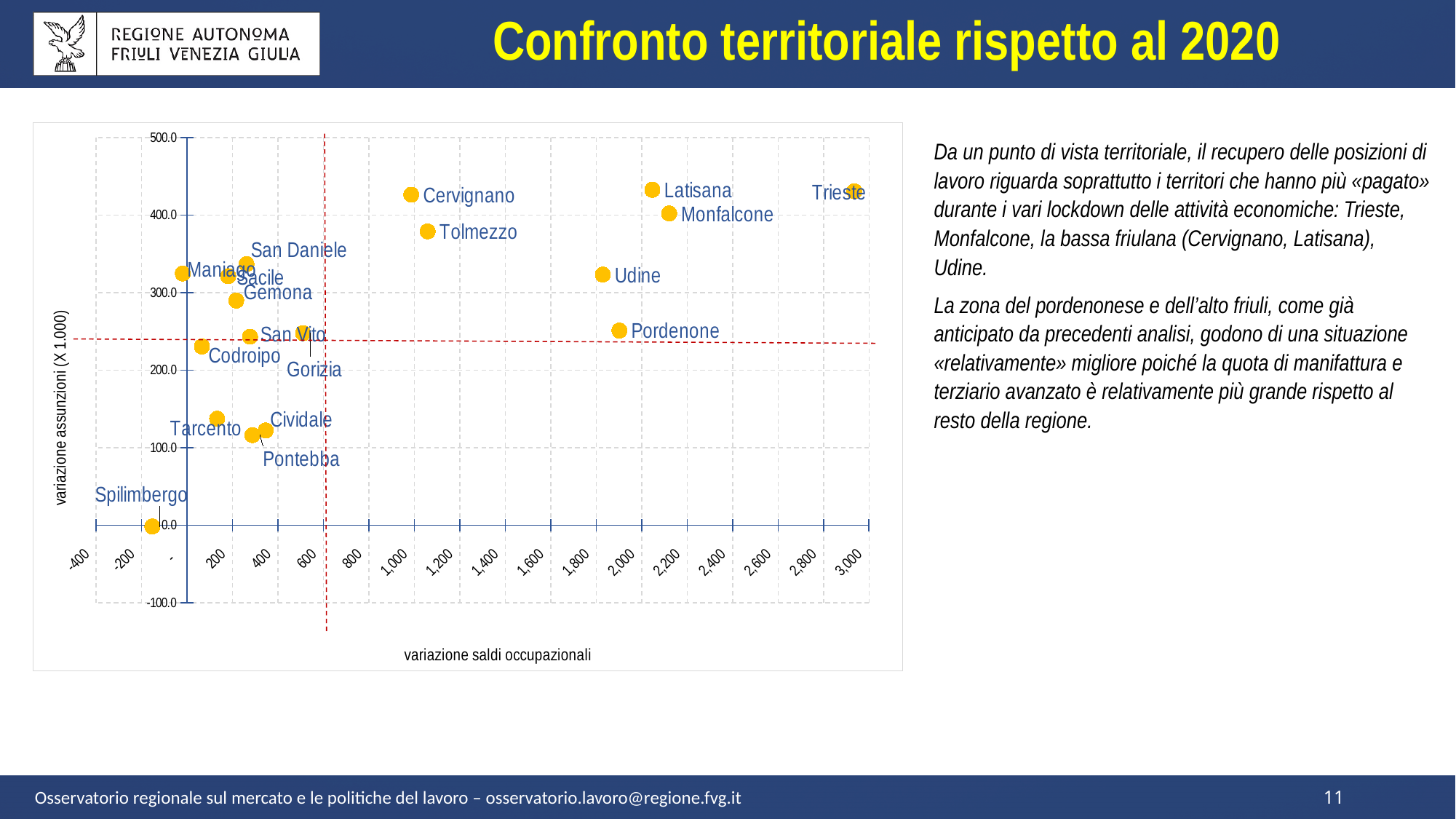
Which territory has the highest value on the horizontal axis (variazione saldi occupazionali)? Trieste Is the horizontal-axis value for Pordenone greater or less than 1,800? greater Is the vertical-axis value for Cervignano greater or less than 400.0? greater What kind of chart is shown on the slide? Scatter chart Which has the higher vertical-axis value, Udine or Pordenone? Udine Which territory has the lowest value on the vertical axis (variazione assunzioni)? Spilimbergo How many labelled territories are plotted on the chart? 18 What is the title of the horizontal axis of the chart? variazione saldi occupazionali Is the vertical-axis value for Udine greater or less than 300.0? greater Which has the larger horizontal-axis value, Trieste or Udine? Trieste